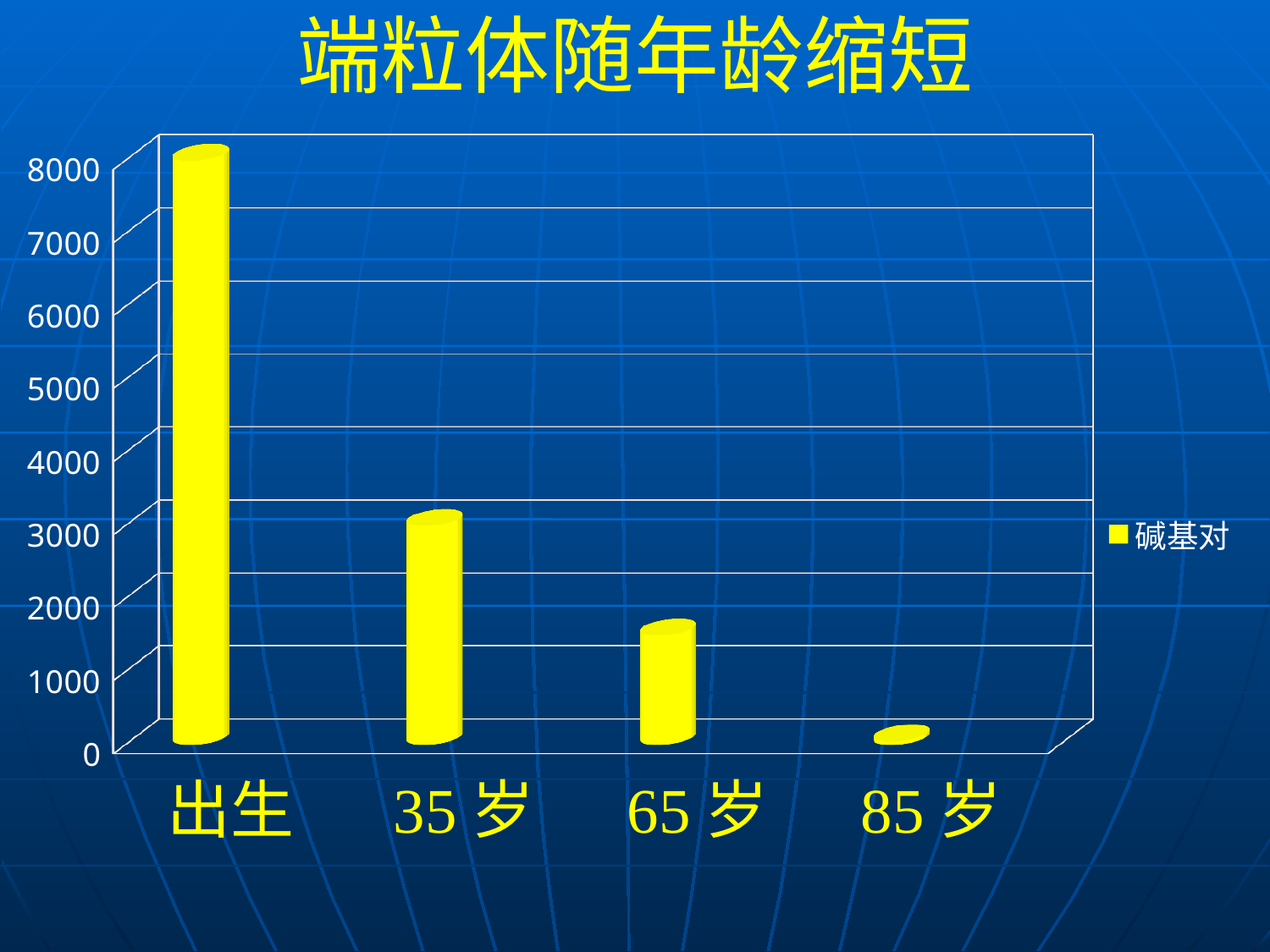
Is the value for 65 岁 greater or less than 1000? greater What series name does the legend list? 碱基对 Which is larger, the value for 35 岁 or the value for 65 岁? 35 岁 Do the values rise or fall from 出生 to 85 岁 along the x axis? fall How many series does the legend list? 1 Is the value for 出生 greater or less than 7000? greater Which category has the highest value? 出生 What is the title of the chart? 端粒体随年龄缩短 How many categories are shown on the x axis? 4 What kind of chart is shown on the slide? bar chart Is the value for 35 岁 greater or less than 4000? less Which category has the lowest value? 85 岁